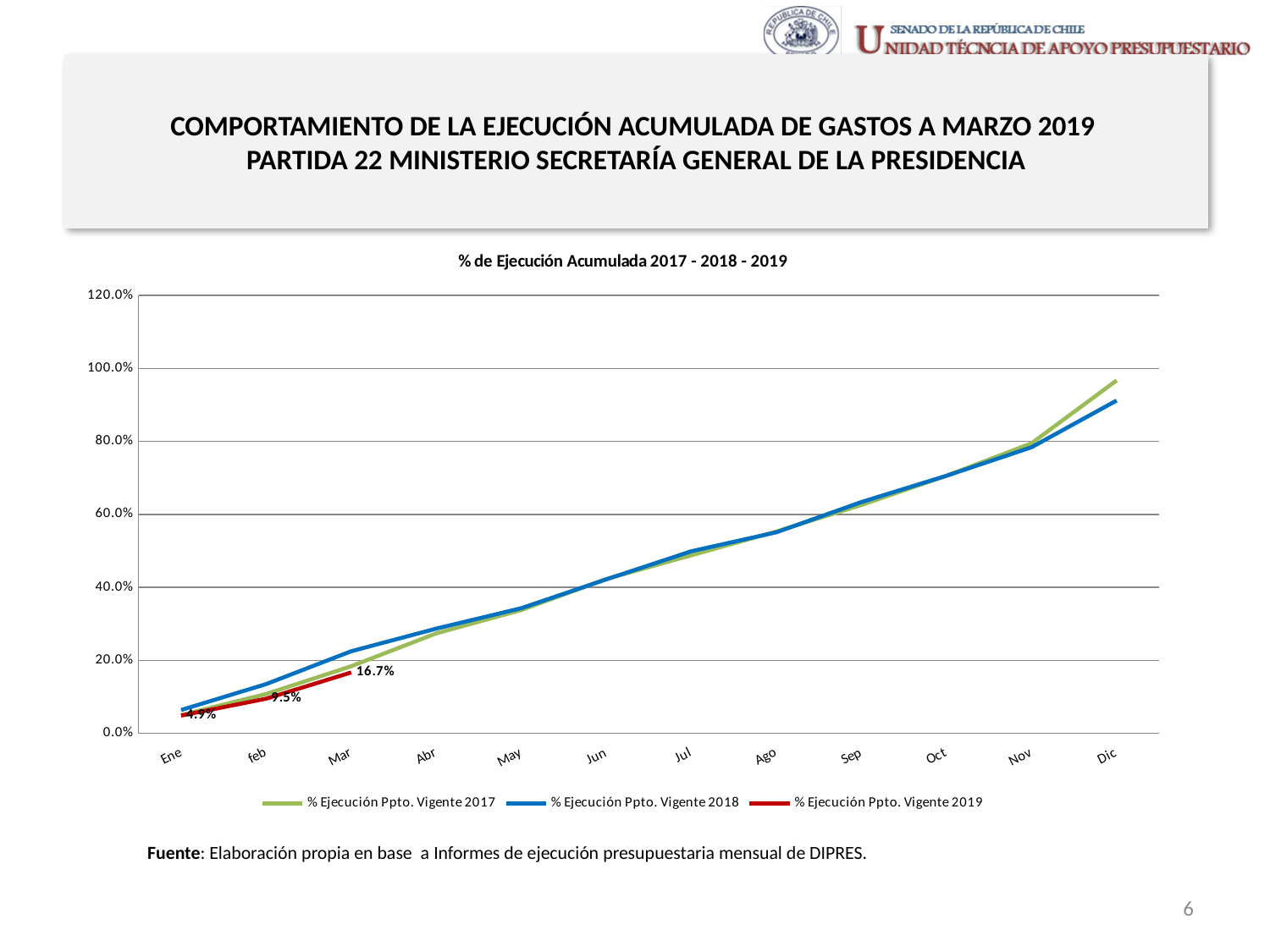
In which month does % Ejecución Ppto. Vigente 2017 reach its highest value? Dic How many months are shown on the x axis? 12 Is the value for % Ejecución Ppto. Vigente 2017 in Dic greater or less than 80.0%? greater What is the value of % Ejecución Ppto. Vigente 2019 in Mar? 16.7% What kind of chart is shown on the slide? line chart Do the values of % Ejecución Ppto. Vigente 2018 rise or fall from Ene to Dic? rise How many series does the chart legend list? 3 What is the value of % Ejecución Ppto. Vigente 2019 in Feb? 9.5% What is the title of the chart? % de Ejecución Acumulada 2017 - 2018 - 2019 Is the value for % Ejecución Ppto. Vigente 2018 in Jun greater or less than 60.0%? less In Dic, which series has the higher value: % Ejecución Ppto. Vigente 2017 or % Ejecución Ppto. Vigente 2018? % Ejecución Ppto. Vigente 2017 By how much did % Ejecución Ppto. Vigente 2019 increase from Feb to Mar? 7.2%